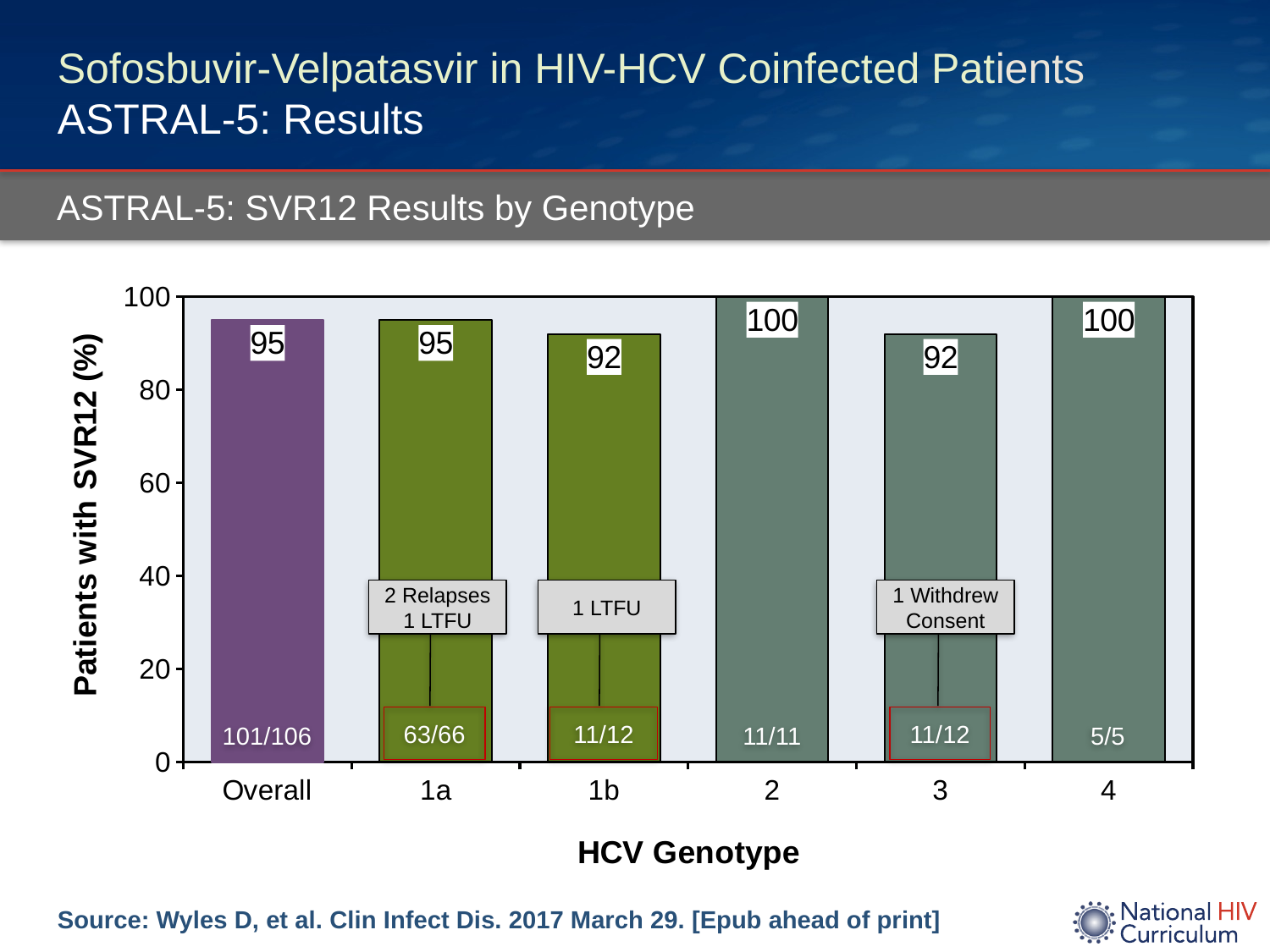
How many categories are shown on the x axis? 6 What is the difference in SVR12 rate (percentage points) between genotype 1a and genotype 1b? 3 Which has a higher SVR12 rate, genotype 2 or genotype 3? Genotype 2 What fraction of patients achieved SVR12 in the Overall group? 101/106 What is the SVR12 rate (%) for genotype 3? 92 What kind of chart is shown on the slide? Bar chart Which HCV genotypes have the highest SVR12 rate? 2 and 4 Which HCV genotypes have the lowest SVR12 rate? 1b and 3 Is the SVR12 rate for the Overall group greater or less than 80? greater What is the SVR12 rate (%) for genotype 1a? 95 What reason is given in the annotation for the non-SVR12 patient in genotype 3? 1 Withdrew Consent What fraction of patients achieved SVR12 for genotype 4? 5/5